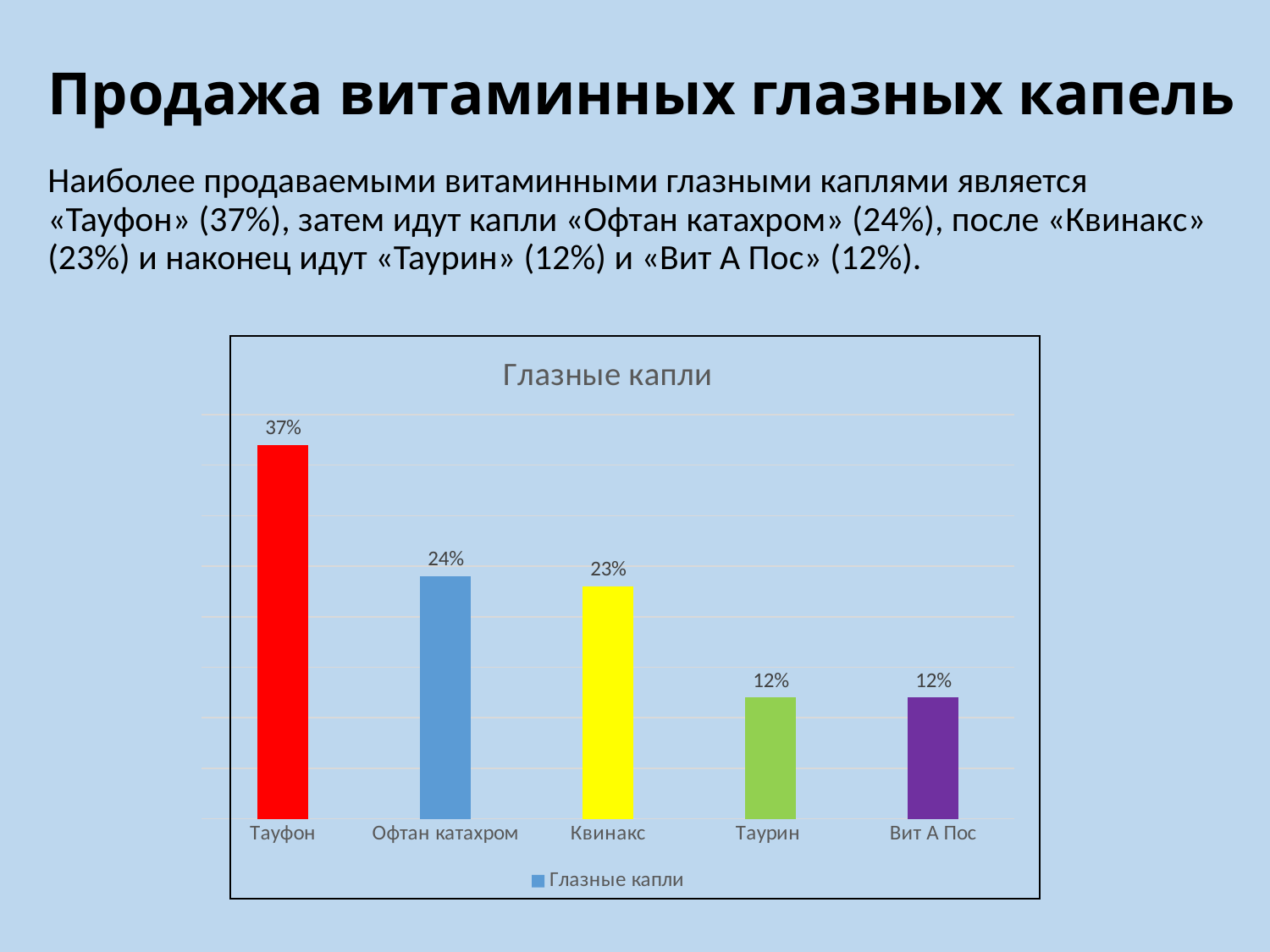
How many series does the legend list? 1 What is the value for Офтан катахром? 24% What is the value for Тауфон? 37% What is the title of the chart? Глазные капли Which category has the highest value? Тауфон What is the value for Квинакс? 23% What is the difference between the values for Квинакс and Вит А Пос? 11% What is the value for Таурин? 12% What is the difference between the values for Тауфон and Офтан катахром? 13% How many categories are shown on the x axis? 5 Which is larger, the value for Тауфон or the value for Квинакс? Тауфон What kind of chart is shown? bar chart